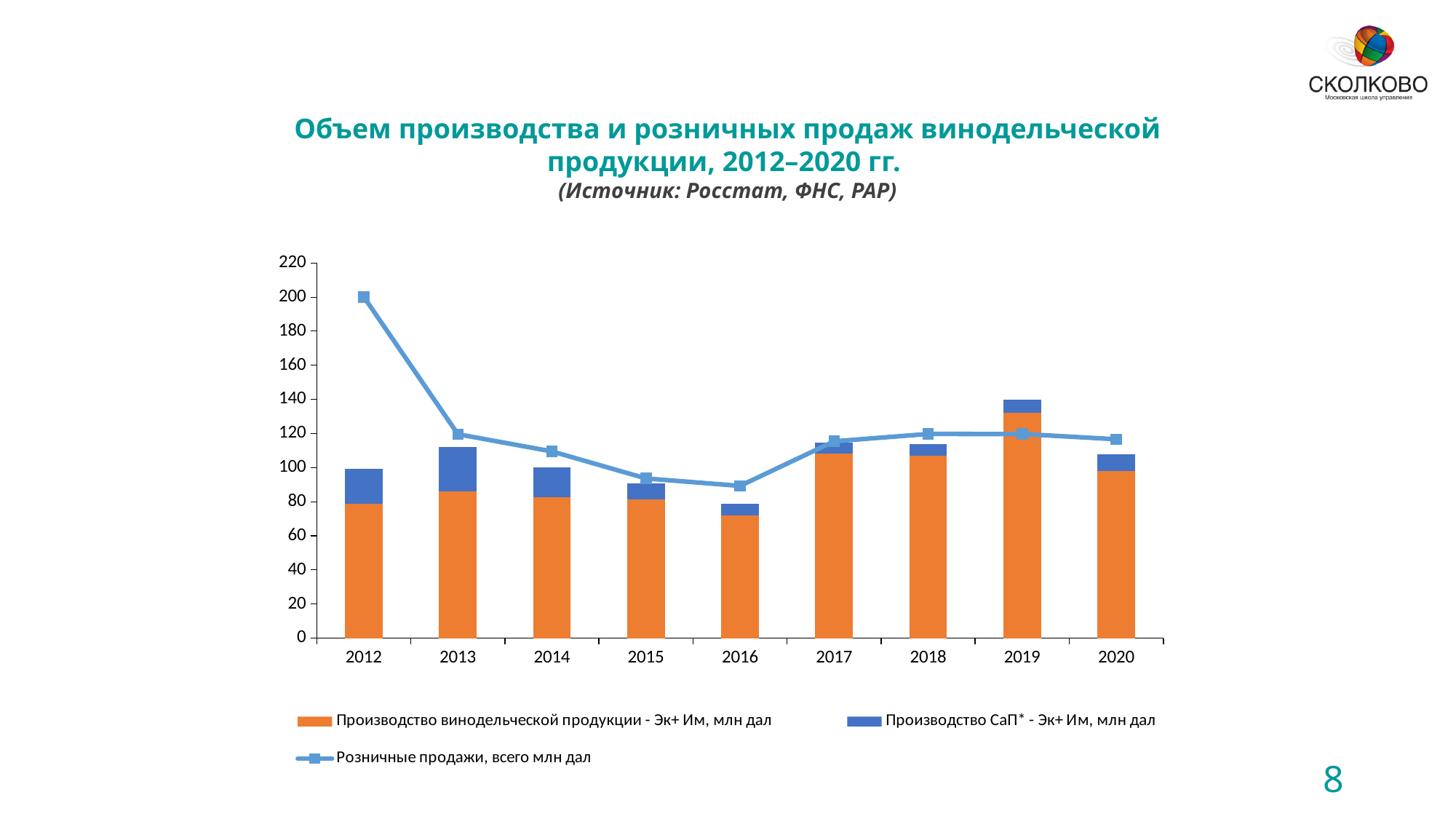
Is the orange bar 'Производство винодельческой продукции - Эк+ Им, млн дал' for 2019 greater or less than 120? greater In which year is the orange bar 'Производство винодельческой продукции - Эк+ Им, млн дал' the tallest? 2019 What kind of chart is shown on the slide? A bar chart with a line How many years are shown on the x axis of the chart? 9 Is the value of 'Розничные продажи, всего млн дал' for 2016 greater or less than 100? less In which year is the orange bar 'Производство винодельческой продукции - Эк+ Им, млн дал' the shortest? 2016 Is the value of 'Розничные продажи, всего млн дал' for 2012 greater or less than 180? greater How many series does the chart legend list? 3 In which year is the line 'Розничные продажи, всего млн дал' at its highest? 2012 In which year is the line 'Розничные продажи, всего млн дал' at its lowest? 2016 Which year has the larger orange bar 'Производство винодельческой продукции - Эк+ Им, млн дал': 2012 or 2019? 2019 Does the line 'Розничные продажи, всего млн дал' rise or fall from 2012 to 2016? fall